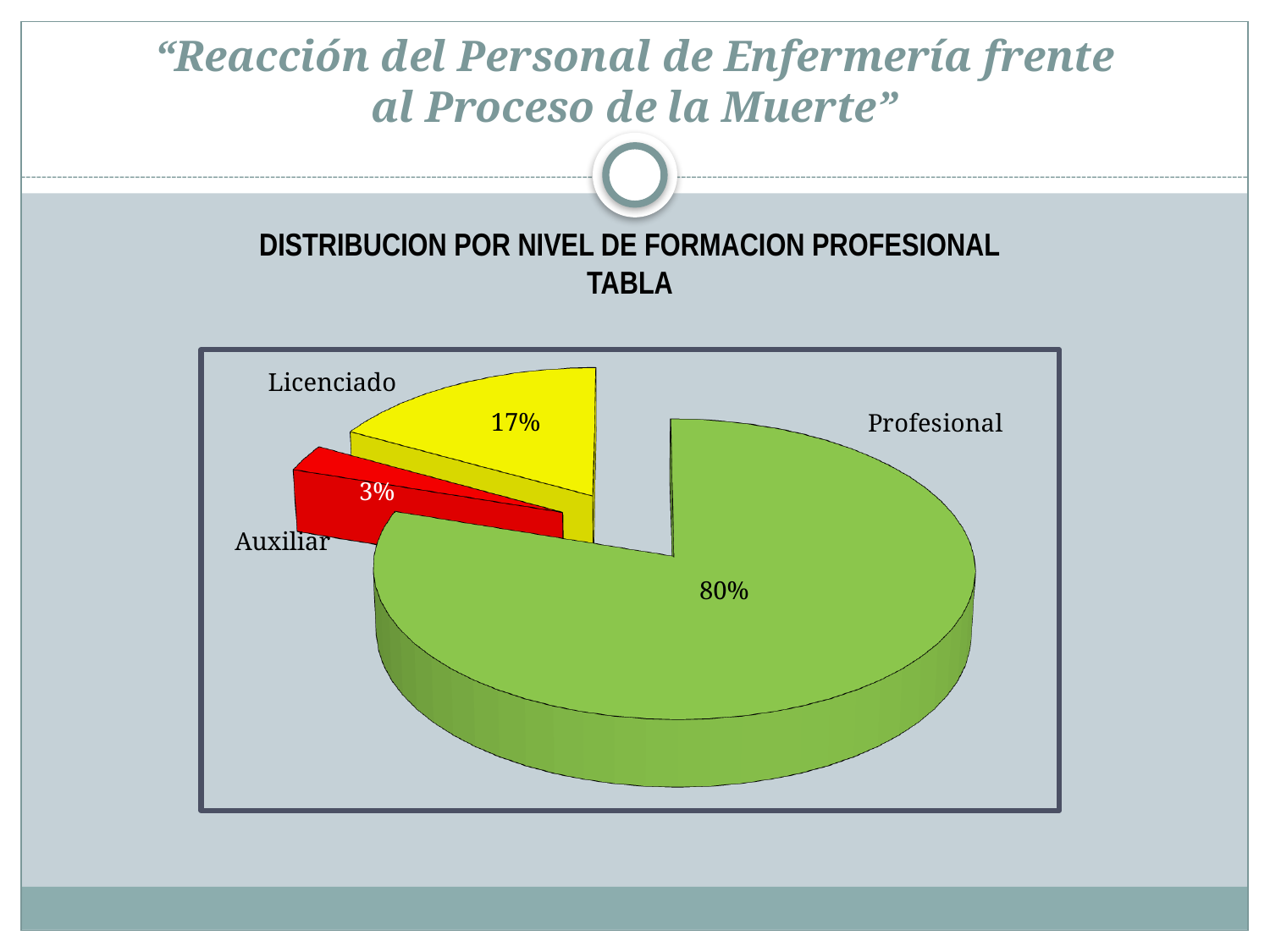
How many slices does the pie chart have? 3 Which slice is larger, Licenciado or Auxiliar? Licenciado What percentage of the pie chart is labelled Licenciado? 17% What percentage of the pie chart is labelled Auxiliar? 3% What kind of chart is shown on the slide? Pie chart What is the difference in percentage points between the Profesional and Licenciado slices? 63 What is the title shown above the pie chart? DISTRIBUCION POR NIVEL DE FORMACION PROFESIONAL TABLA What colour is the Auxiliar slice of the pie chart? Red What percentage of the pie chart is labelled Profesional? 80% Which category has the smallest slice of the pie chart? Auxiliar Which category has the largest slice of the pie chart? Profesional What is the difference in percentage points between the Licenciado and Auxiliar slices? 14